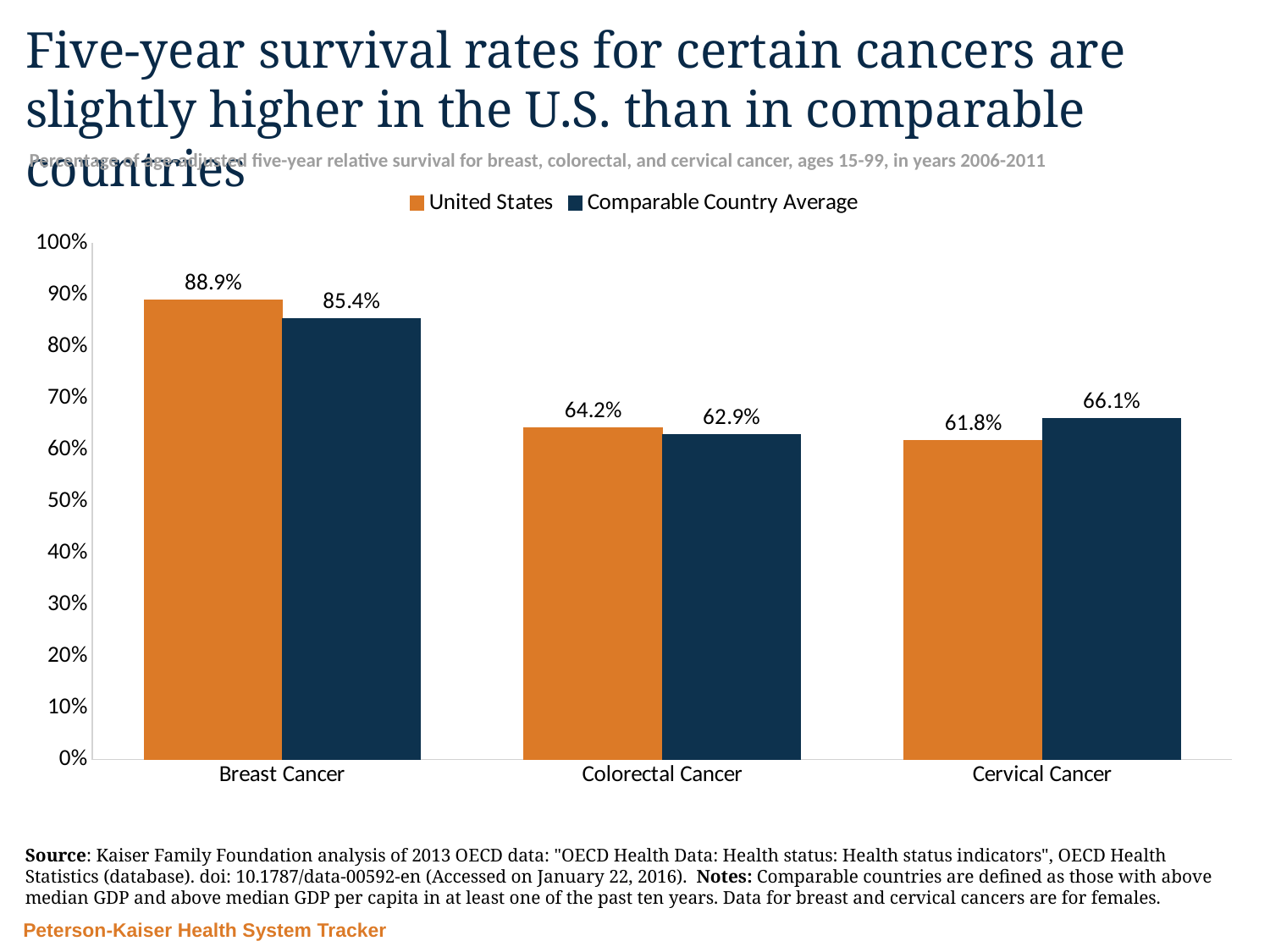
How many cancer types are shown on the x axis? 3 For cervical cancer, which is higher: the United States or the Comparable Country Average? Comparable Country Average What is the United States value for colorectal cancer? 64.2% Which cancer type has the highest United States survival rate? Breast Cancer What kind of chart is shown on the slide? Bar chart How many series does the legend list? 2 What is the five-year survival rate for breast cancer in the United States? 88.9% Is the Comparable Country Average value for colorectal cancer greater or less than 70%? less Which colour represents the United States in the chart? Orange Which cancer type has the lowest Comparable Country Average survival rate? Colorectal Cancer What is the Comparable Country Average five-year survival rate for cervical cancer? 66.1% What is the difference between the United States and Comparable Country Average survival rates for breast cancer? 3.5%